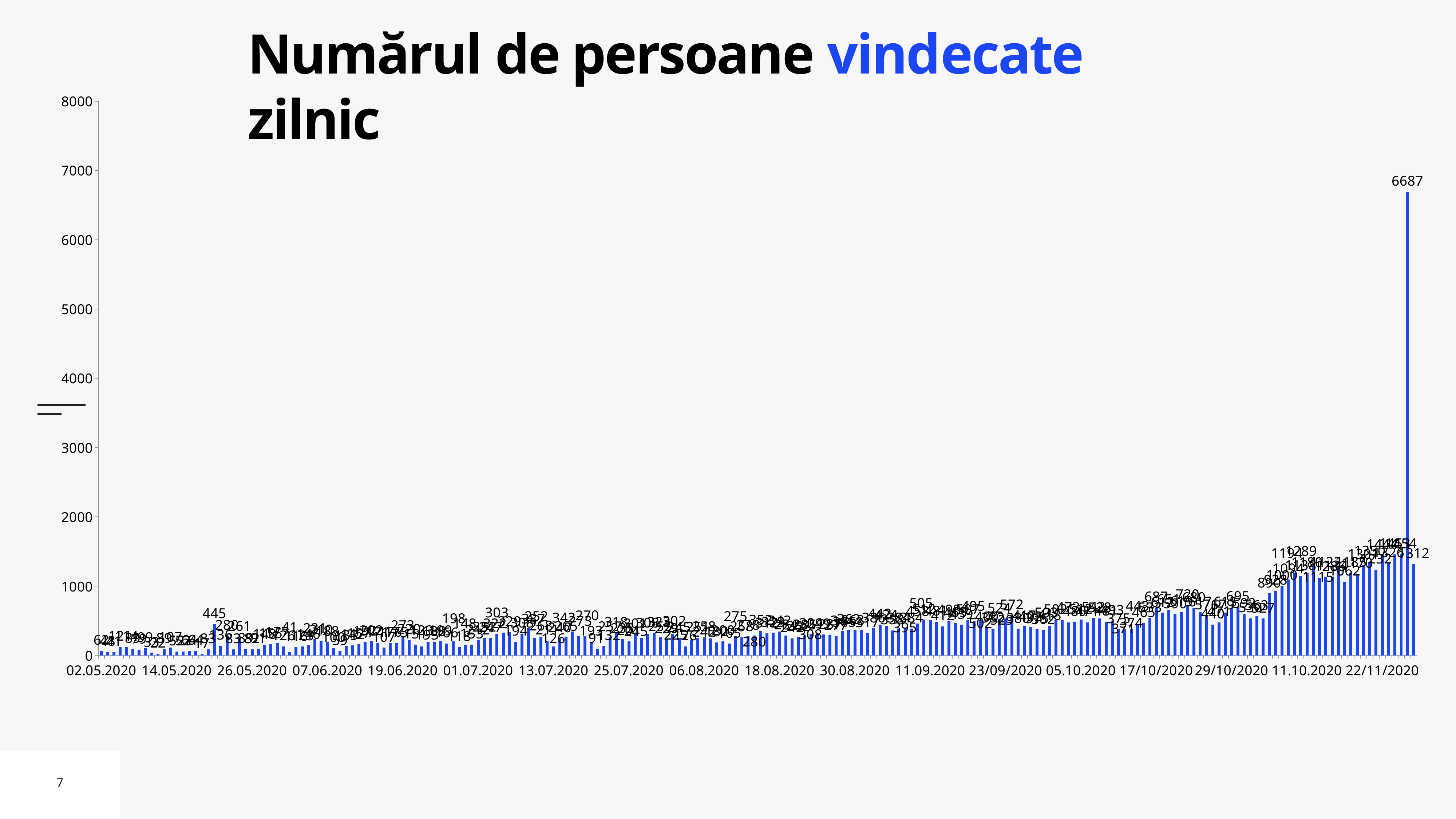
Is the value of the tallest bar greater or less than 6000? greater What kind of chart is shown on the slide? bar chart What is the value of the tallest bar in May 2020? 445 What is the first date label on the x axis? 02.05.2020 What is the title of the chart? Numărul de persoane vindecate zilnic What is the maximum value shown on the y axis? 8000 Is the value for 11.10.2020 greater or less than 1000? greater Do the values generally rise or fall from left to right along the x axis? rise Is the value of the tallest bar greater or less than 7000? less Which is larger, the value for 02.05.2020 or the value of the last bar on the right? the last bar on the right What is the highest value labeled on the chart? 6687